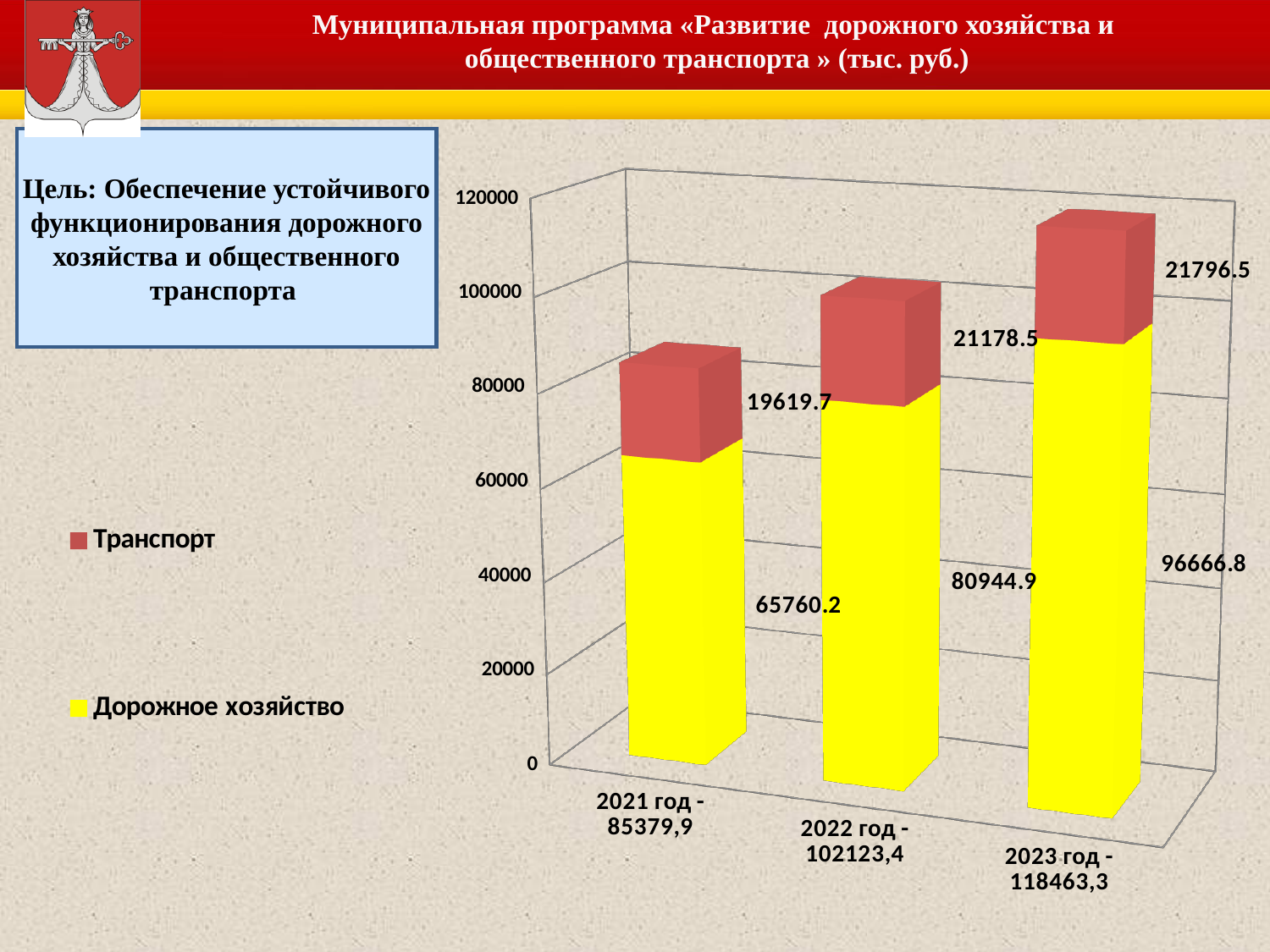
Which is larger: Транспорт in 2021 or Транспорт in 2023? Транспорт in 2023 What is the value for Дорожное хозяйство in 2021? 65760.2 What is the total of the stacked bar for 2022? 102123.4 How many series does the legend list? 2 What is the difference between the Дорожное хозяйство values for 2023 and 2021? 30906.6 What is the value for Дорожное хозяйство in 2022? 80944.9 What is the value for Транспорт in 2023? 21796.5 Do the Дорожное хозяйство values rise or fall from 2021 to 2023? rise What is the value for Транспорт in 2022? 21178.5 How many years are shown on the x axis? 3 Which year has the lowest value for Транспорт? 2021 Which year has the highest value for Дорожное хозяйство? 2023